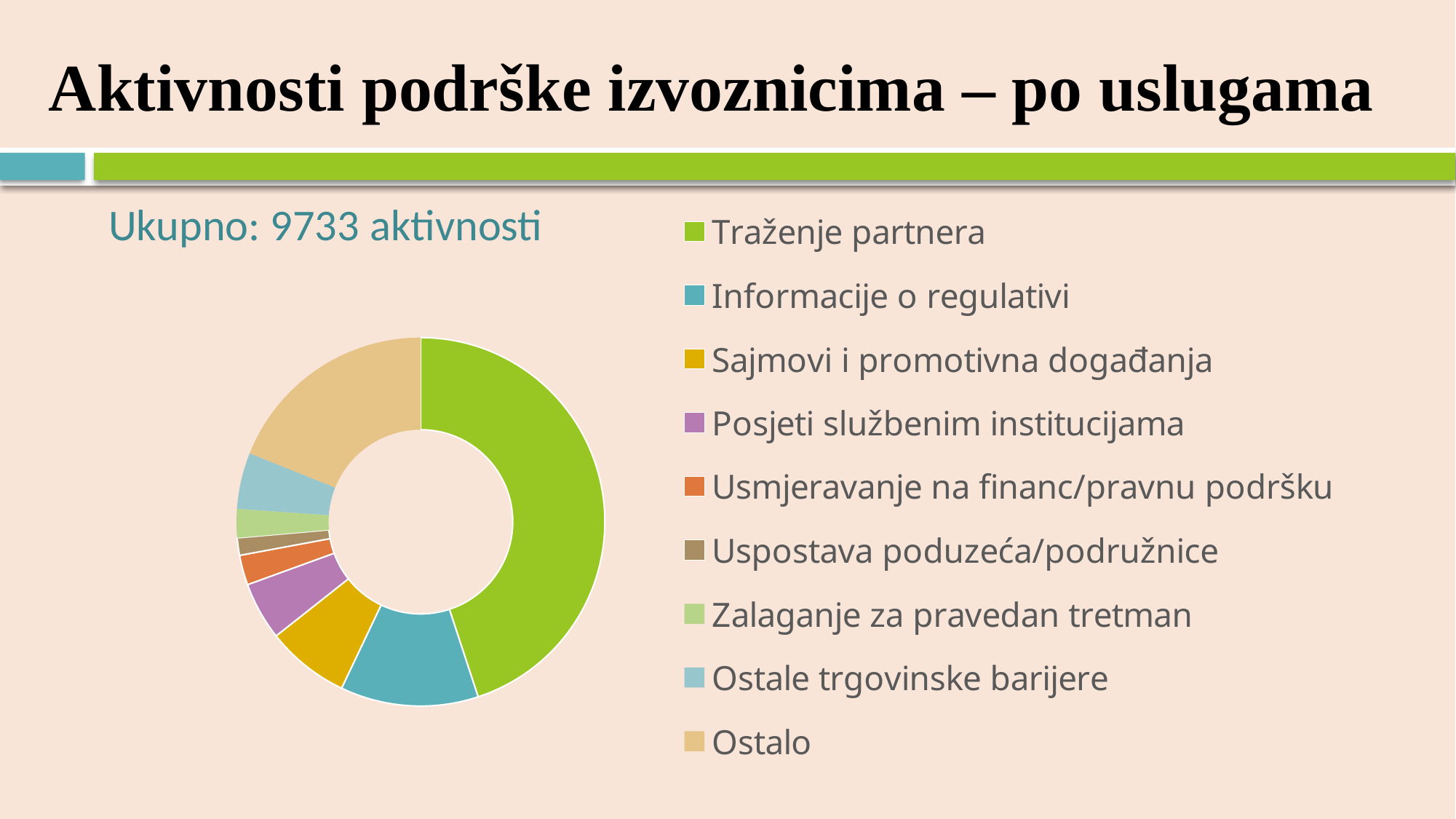
How many categories does the chart's legend list? 9 What kind of chart is shown on the slide? Doughnut (pie) chart Which category is shown in the light green colour that forms the largest slice? Traženje partnera Which is larger: the share for Sajmovi i promotivna događanja or the share for Uspostava poduzeća/podružnice? Sajmovi i promotivna događanja Which is larger: the share for Ostalo or the share for Usmjeravanje na financ/pravnu podršku? Ostalo What total number of activities is stated above the chart? 9733 aktivnosti Which category has the largest share of the chart? Traženje partnera Which is larger: the share for Traženje partnera or the share for Ostalo? Traženje partnera